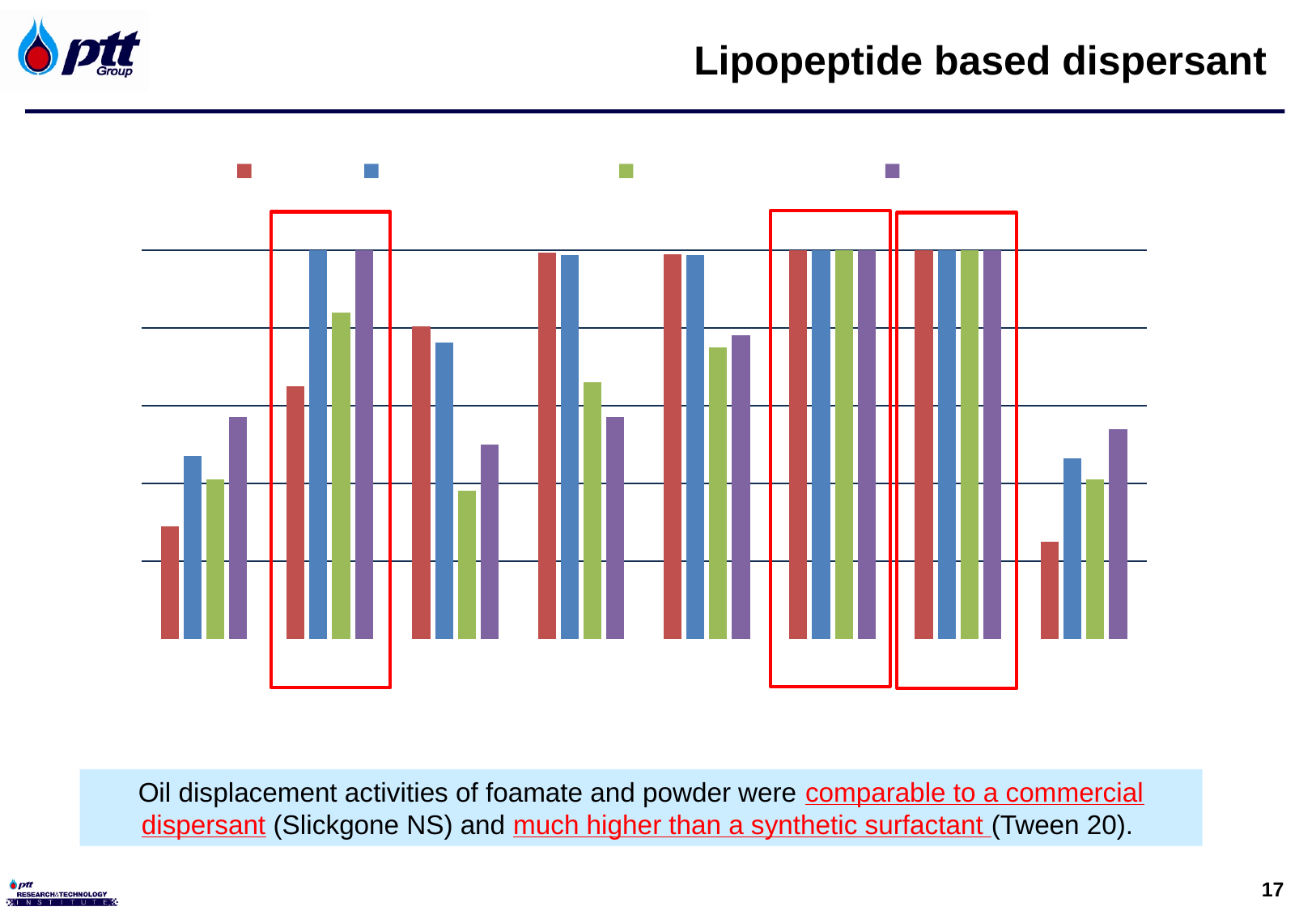
In the leftmost group of bars, which coloured bar is the shortest? red How many groups of bars are outlined with red rectangles? 3 What colours are the four series in the legend, from left to right? red, blue, green, purple How many bars are in each group? 4 In the third group from the left, is the green bar taller or shorter than the purple bar? shorter How many series does the legend list? 4 In the rightmost group of bars, which coloured bar is the shortest? red In the leftmost group of bars, which coloured bar is the tallest? purple How many groups of bars are plotted in the chart? 8 In the second group from the left, is the blue bar taller or shorter than the red bar? taller What kind of chart is shown on the slide? bar chart